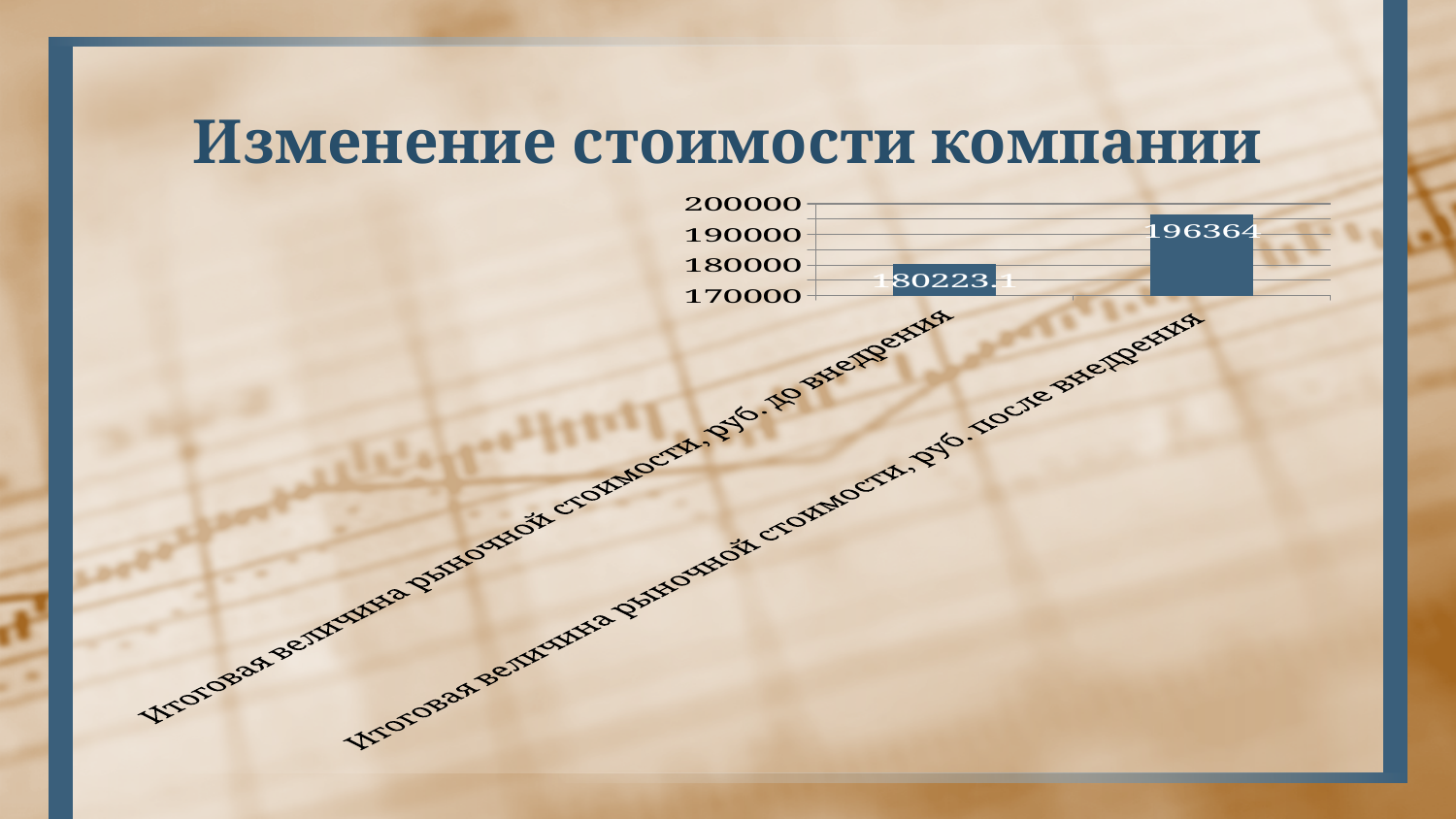
Which category has the lowest value? Итоговая величина рыночной стоимости, руб. до внедрения Which category has the highest value? Итоговая величина рыночной стоимости, руб. после внедрения What kind of chart is shown on the slide? bar chart Is the value for "Итоговая величина рыночной стоимости, руб. до внедрения" greater or less than 190000? less Which is larger: the value before implementation (до внедрения) or after implementation (после внедрения)? после внедрения What is the value for "Итоговая величина рыночной стоимости, руб. после внедрения"? 196364 Do the values rise or fall from the first bar to the second bar? rise What is the value for "Итоговая величина рыночной стоимости, руб. до внедрения"? 180223.1 What is the difference between the value after implementation (после внедрения) and the value before implementation (до внедрения)? 16140.9 How many bars are plotted in the chart? 2 What is the title of the slide? Изменение стоимости компании Is the value for "Итоговая величина рыночной стоимости, руб. после внедрения" greater or less than 190000? greater